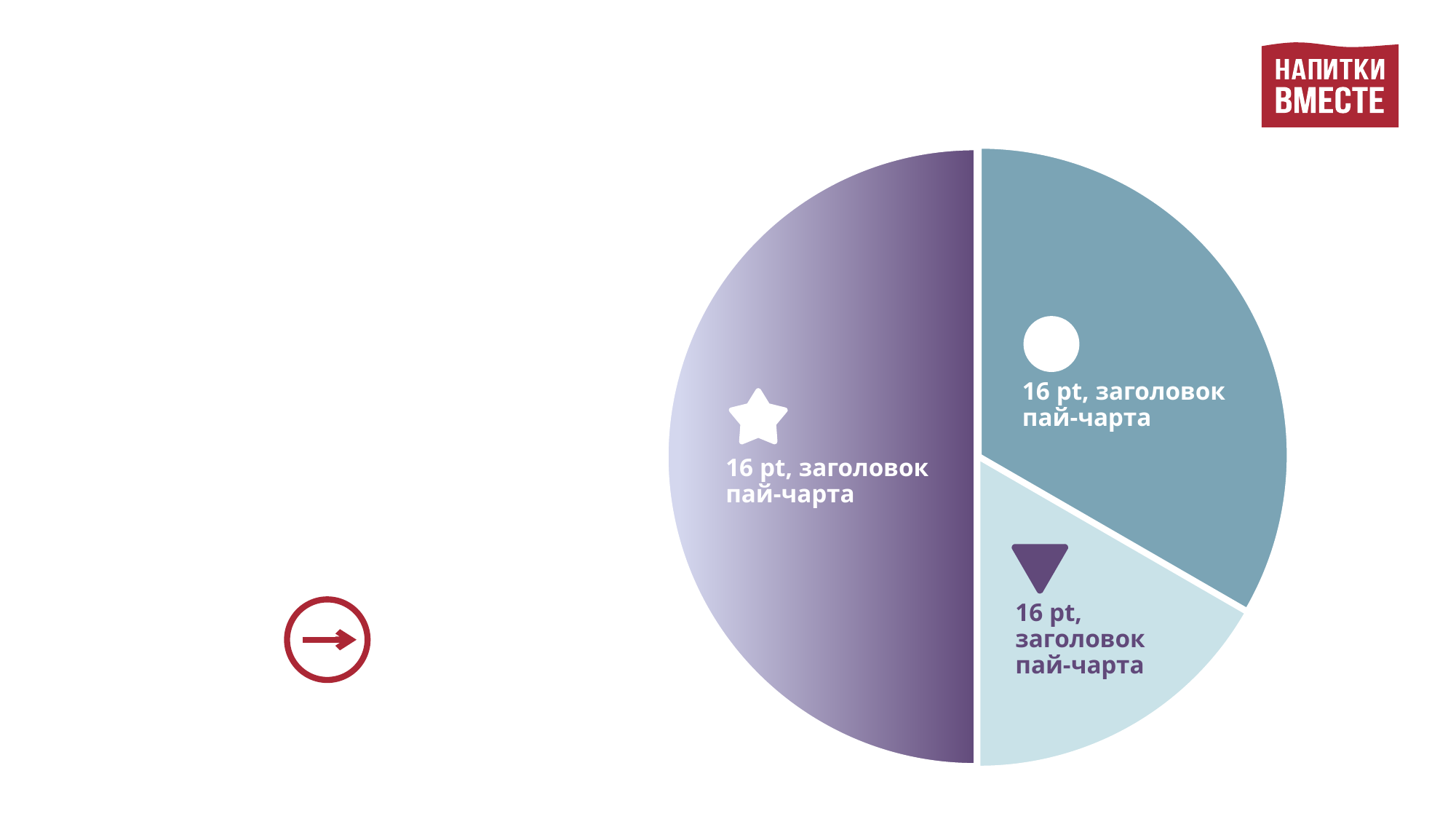
How many slices does the pie chart have? 3 What text label appears on each slice of the pie chart? 16 pt, заголовок пай-чарта What kind of chart is shown on the slide? pie chart Which slice of the pie chart is the largest? the purple slice on the left Which is larger: the purple slice or the light blue slice? the purple slice Which slice of the pie chart is the smallest? the light blue slice at the lower right Which is larger: the teal slice at the upper right or the light blue slice at the lower right? the teal slice What icon is shown on the purple slice of the pie chart? a star